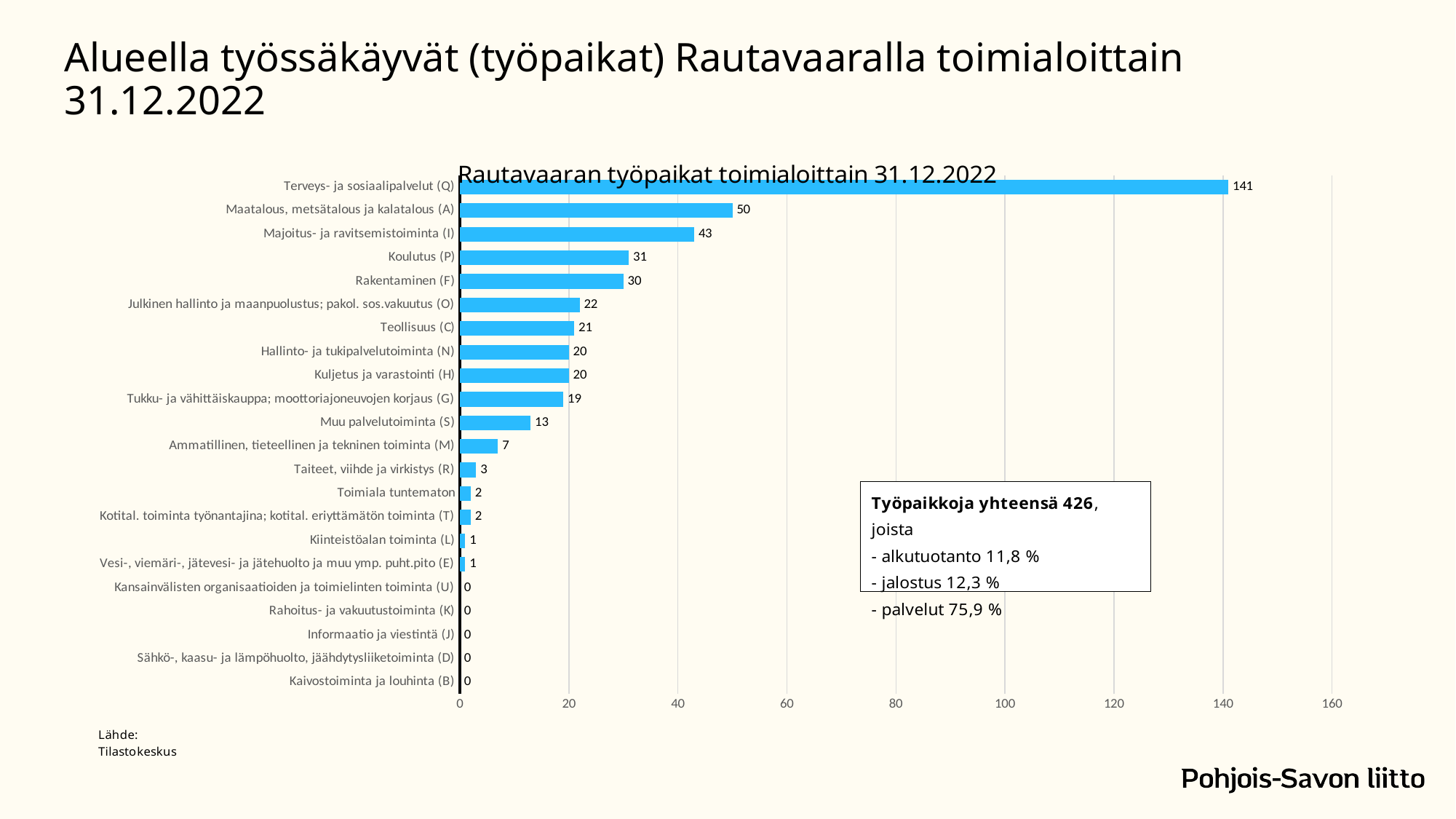
What is the value for Terveys- ja sosiaalipalvelut (Q)? 141 What is the title of the chart? Rautavaaran työpaikat toimialoittain 31.12.2022 How many categories are shown on the chart? 22 Which is larger, Teollisuus (C) or Tukku- ja vähittäiskauppa; moottoriajoneuvojen korjaus (G)? Teollisuus (C) What is the value for Majoitus- ja ravitsemistoiminta (I)? 43 What is the value for Rakentaminen (F)? 30 What kind of chart is shown on the slide? bar chart Is the value for Terveys- ja sosiaalipalvelut (Q) greater or less than 120? greater What is the difference between Maatalous, metsätalous ja kalatalous (A) and Koulutus (P)? 19 Which category has the highest value? Terveys- ja sosiaalipalvelut (Q) What is the value for Muu palvelutoiminta (S)? 13 What is the difference between Terveys- ja sosiaalipalvelut (Q) and Maatalous, metsätalous ja kalatalous (A)? 91